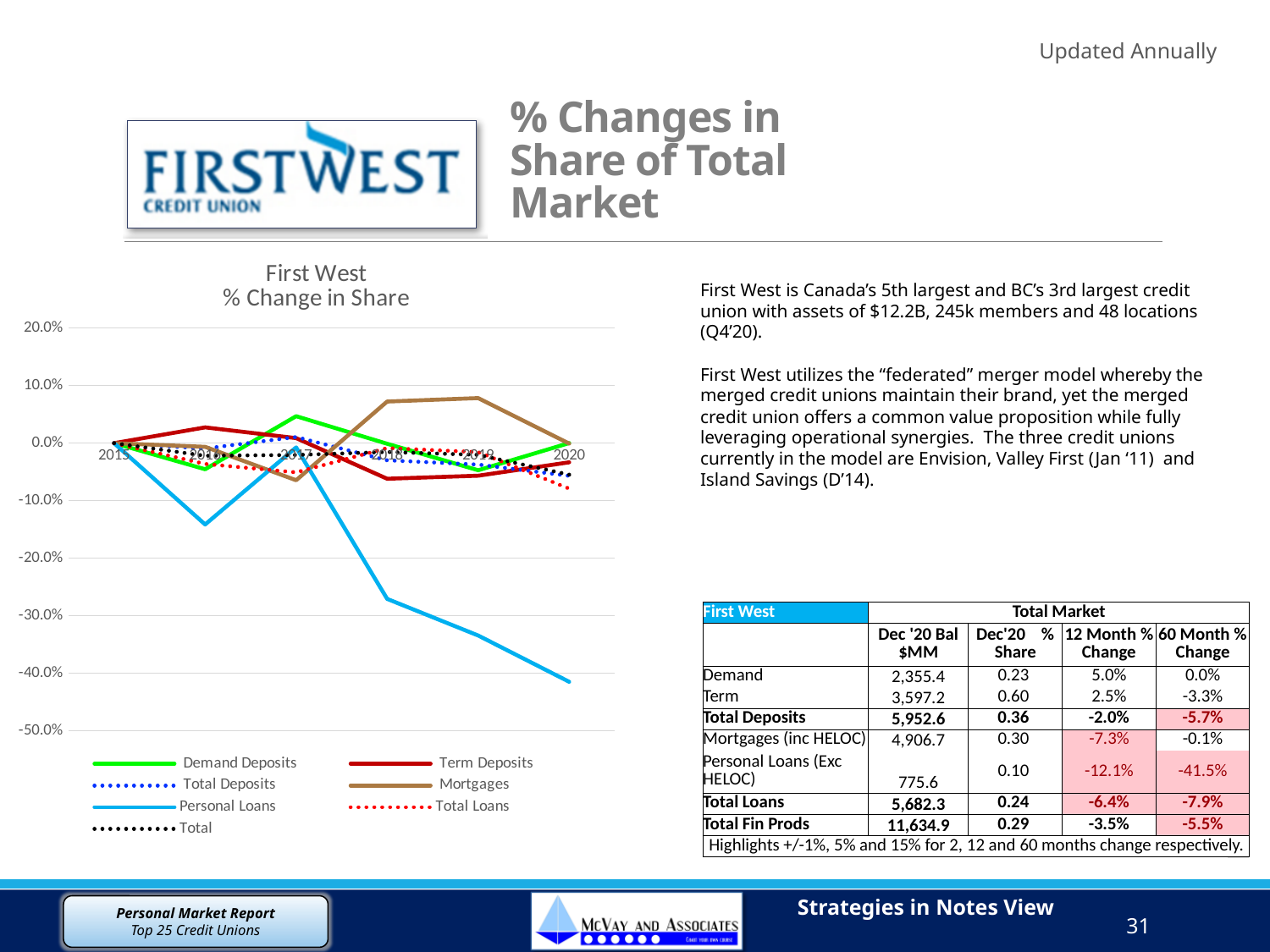
Which series is highest in 2018? Mortgages Which is larger in 2019, the value for Mortgages or the value for Personal Loans? Mortgages Is the value for Mortgages in 2018 greater or less than 0.0%? greater How many years are shown along the x axis of the chart? 6 What kind of chart is shown on the slide? line chart Is the value for Personal Loans in 2020 greater or less than -30.0%? less Does the Personal Loans line rise or fall from 2017 to 2020? fall Which series is lowest in 2016? Personal Loans Is the value for Personal Loans in 2018 greater or less than -20.0%? less How many series does the chart legend list? 7 Which series is lowest in 2020? Personal Loans What is the title of the chart? First West % Change in Share